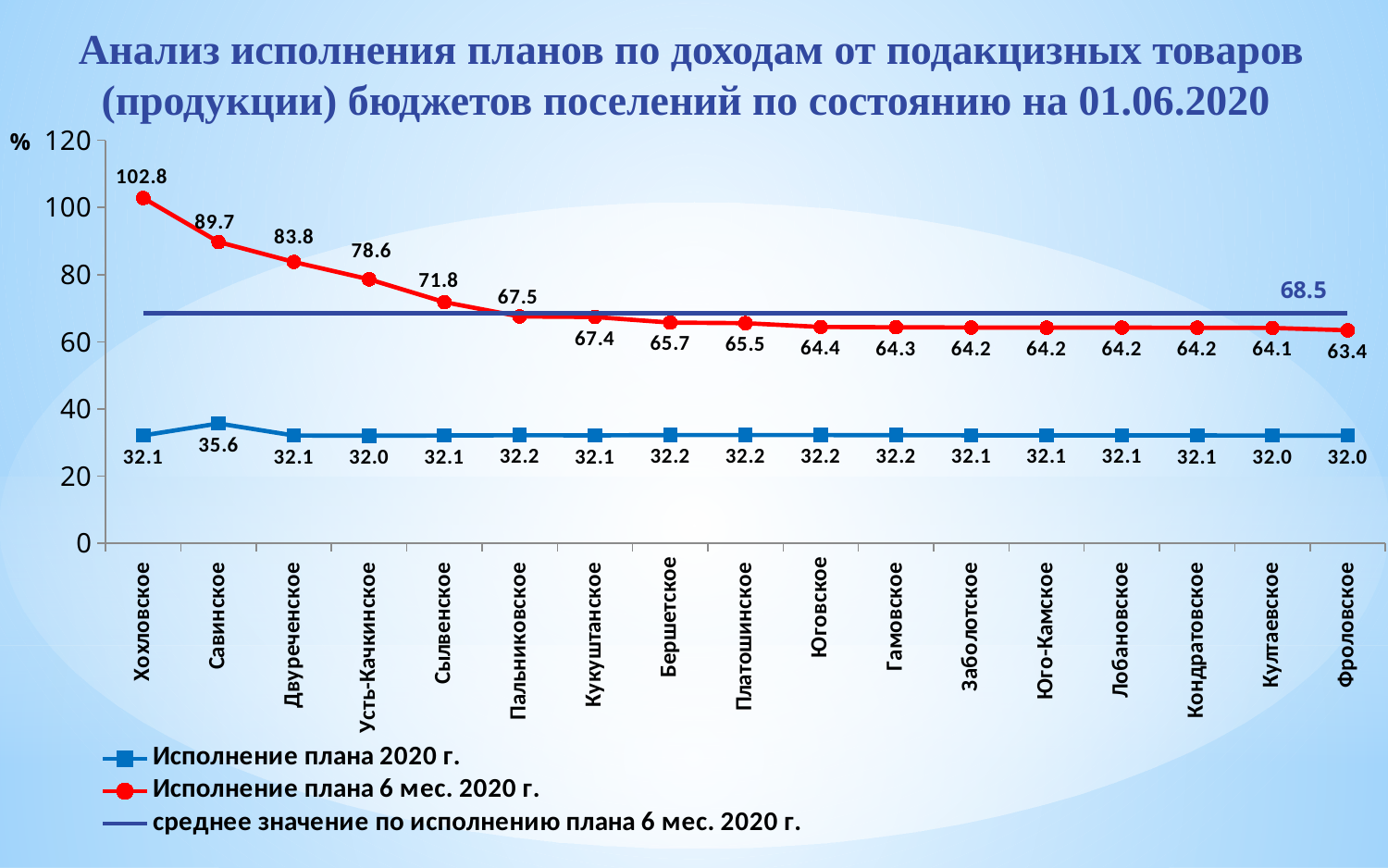
Which settlement has the highest value for 'Исполнение плана 6 мес. 2020 г.'? Хохловское Which is larger: the 'Исполнение плана 6 мес. 2020 г.' value for Сылвенское or for Пальниковское? Сылвенское What is the value of 'Исполнение плана 6 мес. 2020 г.' for Хохловское? 102.8 What is the value of the line 'среднее значение по исполнению плана 6 мес. 2020 г.'? 68.5 How many settlements are shown along the x axis? 17 How many series does the legend list? 3 What kind of chart is shown on the slide? line chart Does the 'Исполнение плана 6 мес. 2020 г.' series rise or fall from left to right along the x axis? fall What is the difference between the 'Исполнение плана 6 мес. 2020 г.' values for Хохловское and Савинское? 13.1 What is the value of 'Исполнение плана 6 мес. 2020 г.' for Фроловское? 63.4 What is the value of 'Исполнение плана 2020 г.' for Савинское? 35.6 Which settlement has the lowest value for 'Исполнение плана 6 мес. 2020 г.'? Фроловское